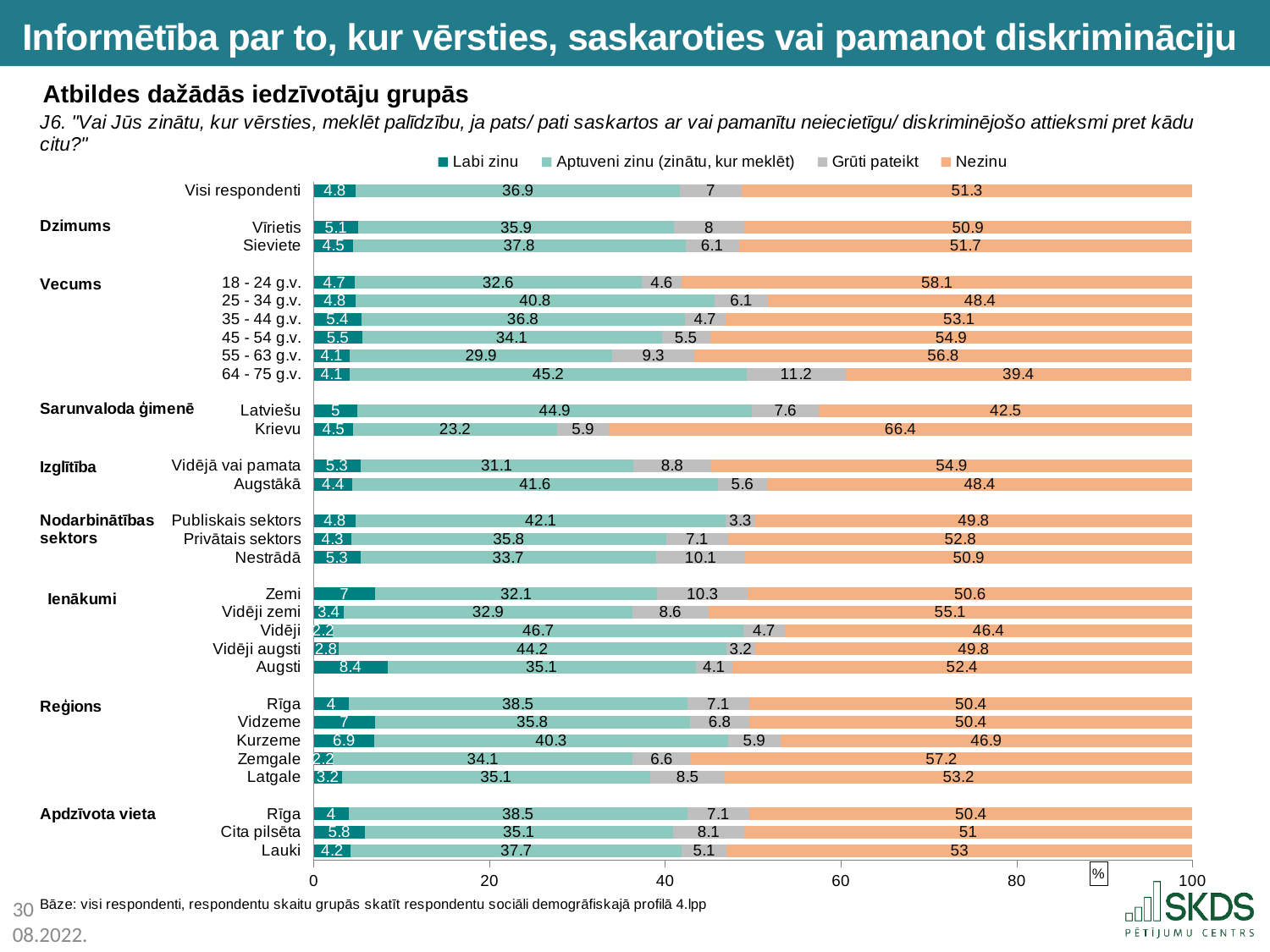
Which has a larger "Aptuveni zinu (zinātu, kur meklēt)" value, "Latviešu" or "Krievu"? Latviešu How many series does the legend list? 4 What is the difference between the "Nezinu" values for "Sieviete" and "Vīrietis"? 0.8 What kind of chart is shown on the slide? Stacked bar chart Which category has the highest value in the "Nezinu" series? Krievu What is the value of the "Grūti pateikt" series for the "64 - 75 g.v." age group? 11.2 Which category has the highest value in the "Aptuveni zinu (zinātu, kur meklēt)" series? Vidēji Which category has the lowest value in the "Nezinu" series? 64 - 75 g.v. What is the value of the "Nezinu" series for "Visi respondenti"? 51.3 What is the total of the stacked bar for "Visi respondenti"? 100 What is the last entry in the chart legend? Nezinu What is the value of the "Labi zinu" series for the "Augsti" income group? 8.4